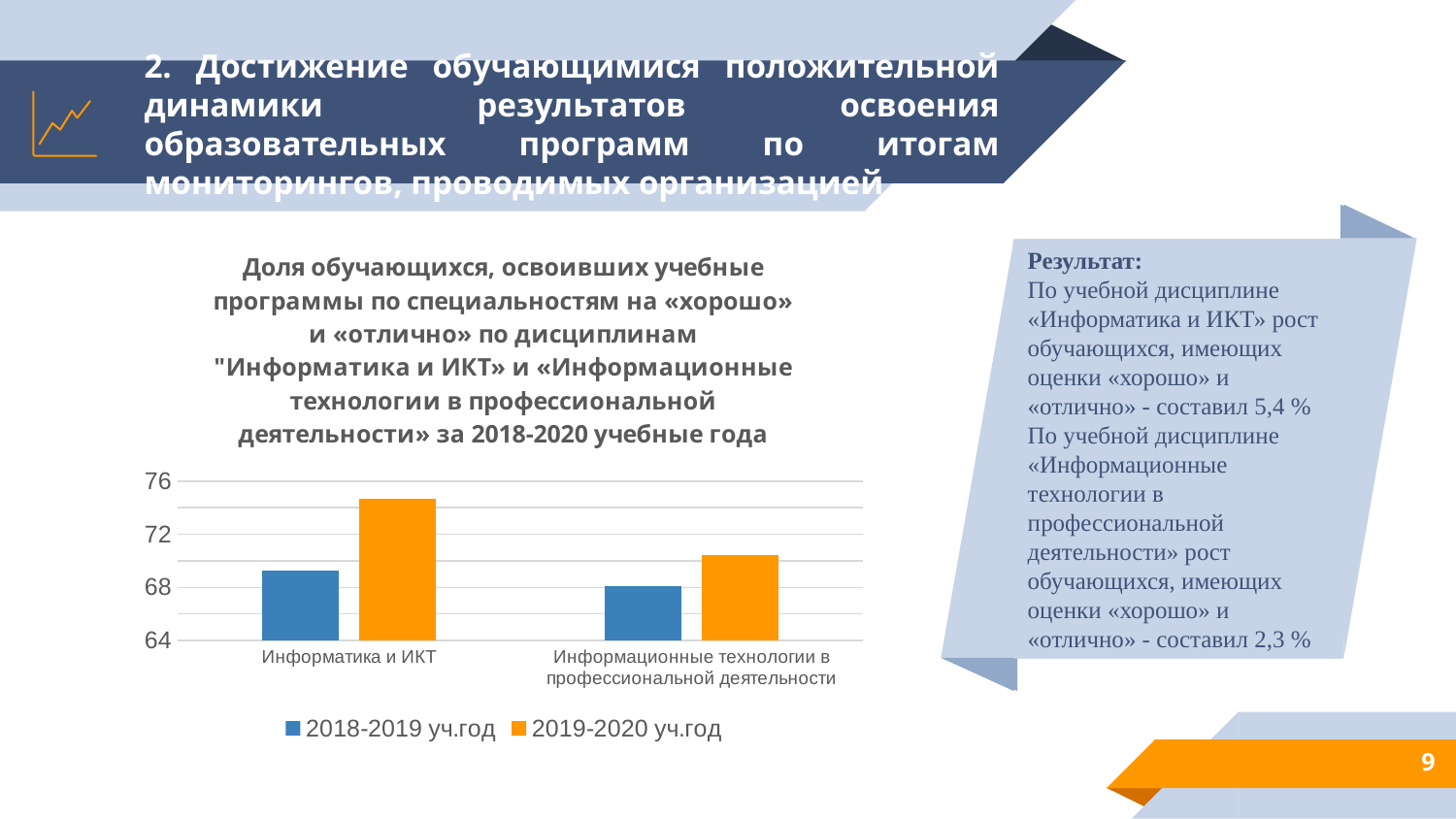
Which bar in the chart is the highest? Информатика и ИКТ, 2019-2020 уч.год Which bar in the chart is the lowest? Информационные технологии в профессиональной деятельности, 2018-2019 уч.год What kind of chart is shown on the slide? bar chart Is the value for Информатика и ИКТ in 2018-2019 уч.год greater or less than 68? greater Is the value for Информатика и ИКТ in 2019-2020 уч.год greater or less than 72? greater For Информатика и ИКТ, which year has the larger value: 2018-2019 уч.год or 2019-2020 уч.год? 2019-2020 уч.год Is the value for Информационные технологии в профессиональной деятельности in 2019-2020 уч.год greater or less than 72? less Which series is shown in orange in the chart? 2019-2020 уч.год For Информационные технологии в профессиональной деятельности, which year has the larger value: 2018-2019 уч.год or 2019-2020 уч.год? 2019-2020 уч.год How many series does the chart legend list? 2 Which series is shown in blue in the chart? 2018-2019 уч.год How many categories are shown on the x axis of the chart? 2